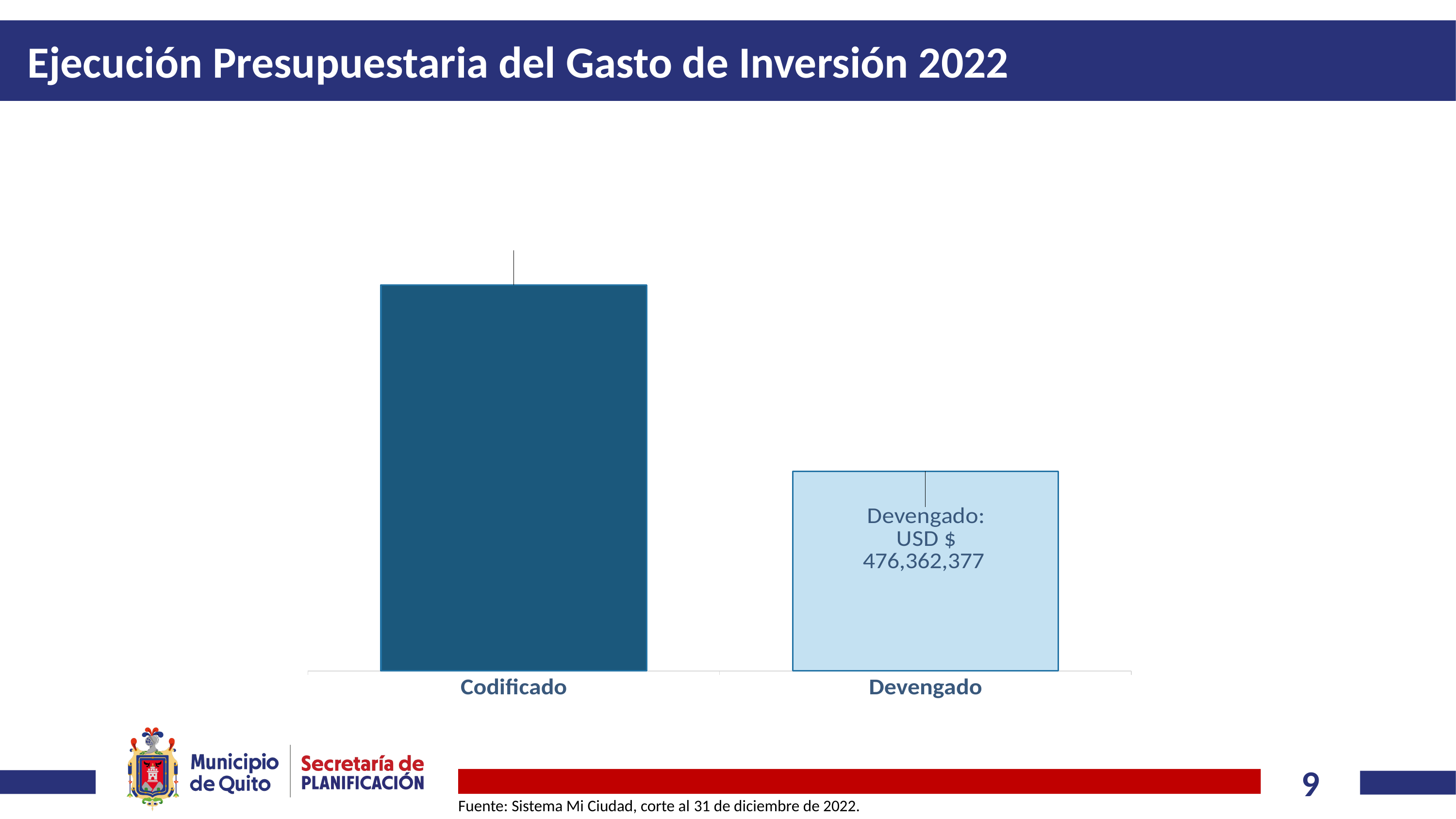
What is the value shown for Devengado? USD $ 476,362,377 What is the title of the slide containing the chart? Ejecución Presupuestaria del Gasto de Inversión 2022 Do the values rise or fall from Codificado to Devengado? Fall Which bar is drawn in the lighter blue colour? Devengado How many categories are shown on the x axis? 2 Which category has the lowest bar? Devengado What kind of chart is shown on the slide? Bar chart Which is larger, Codificado or Devengado? Codificado What is the label of the first category on the x axis? Codificado Which category has the highest bar? Codificado